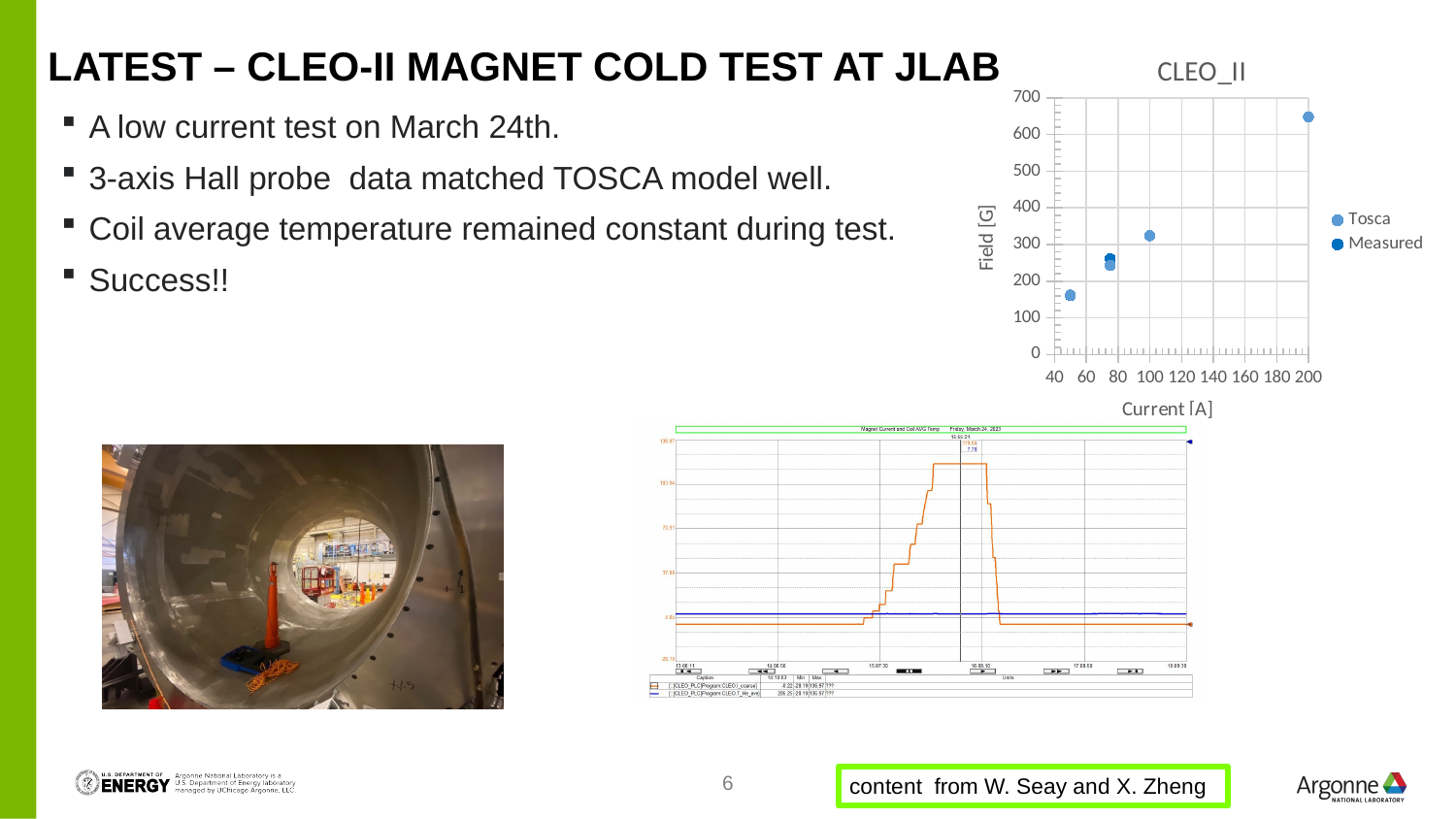
In the CLEO_II chart, is the field value at 100 A greater or less than 300? greater In the CLEO_II chart, does the field rise or fall as the current increases? rises What kind of chart is the CLEO_II chart on the slide? scatter chart What is the title of the scatter chart in the top right of the slide? CLEO_II In the CLEO_II chart, is the field value at 200 A greater or less than 700? less In the CLEO_II chart, at which current is the plotted field highest? 200 A In the CLEO_II chart, which has the larger field value: the point at 100 A or the point at 200 A? 200 A In the CLEO_II chart, is the field value at 200 A greater or less than 600? greater How many series does the legend of the CLEO_II chart list? 2 What are the two series named in the legend of the CLEO_II chart? Tosca and Measured